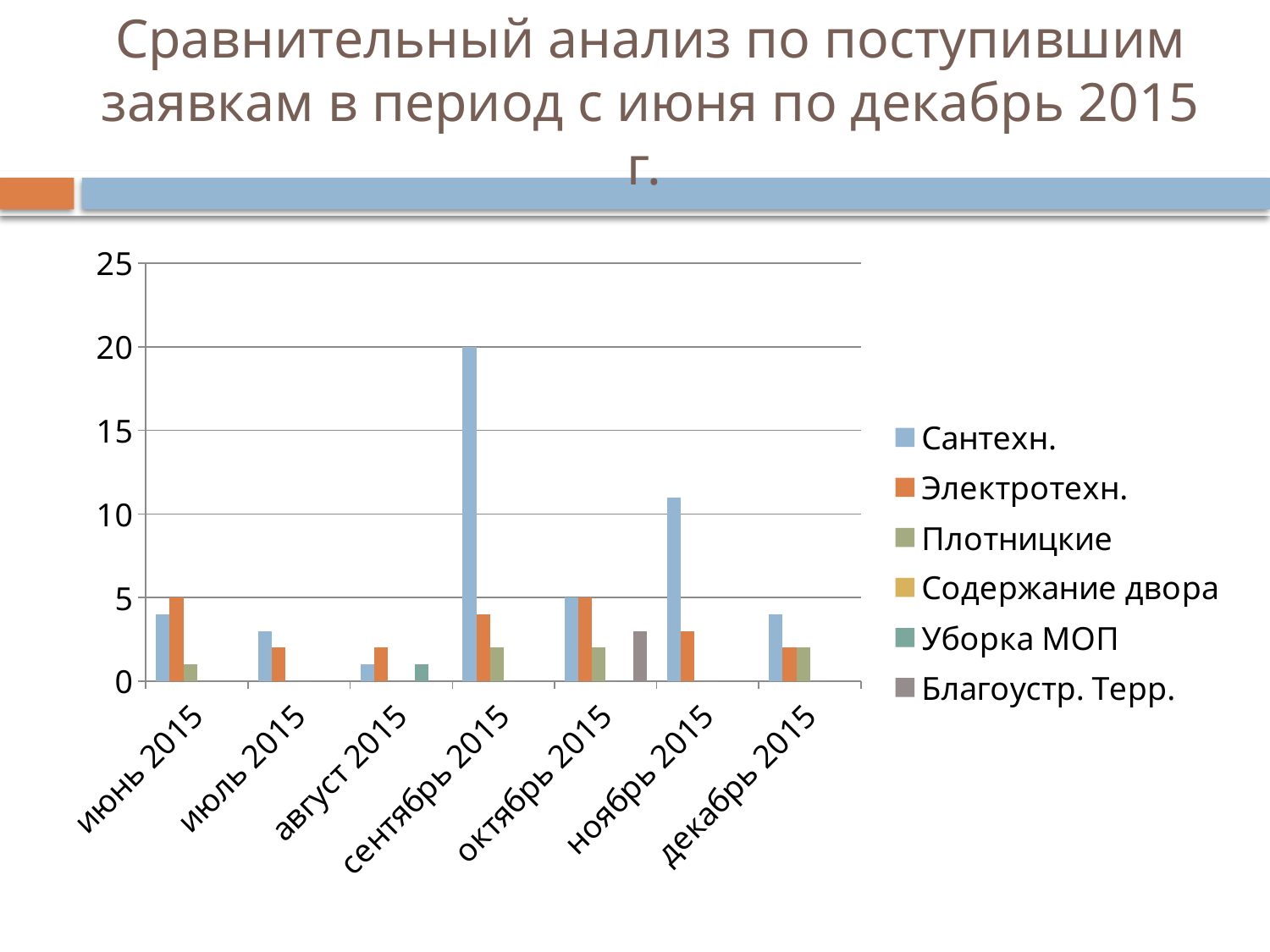
What colour are the Сантехн. bars? blue What is the difference between the Сантехн. value in сентябрь 2015 and in октябрь 2015? 15 What kind of chart is shown on the slide? bar chart What is the value for Сантехн. in сентябрь 2015? 20 Is the value for Сантехн. in ноябрь 2015 greater or less than 10? greater In which month is the Сантехн. bar the lowest? август 2015 What is the value for Электротехн. in июнь 2015? 5 Is the value for Сантехн. in июнь 2015 greater or less than 5? less How many series does the legend list? 6 How many months are shown on the x axis? 7 In which month is the Сантехн. bar the highest? сентябрь 2015 In июль 2015, which is larger: Сантехн. or Электротехн.? Сантехн.